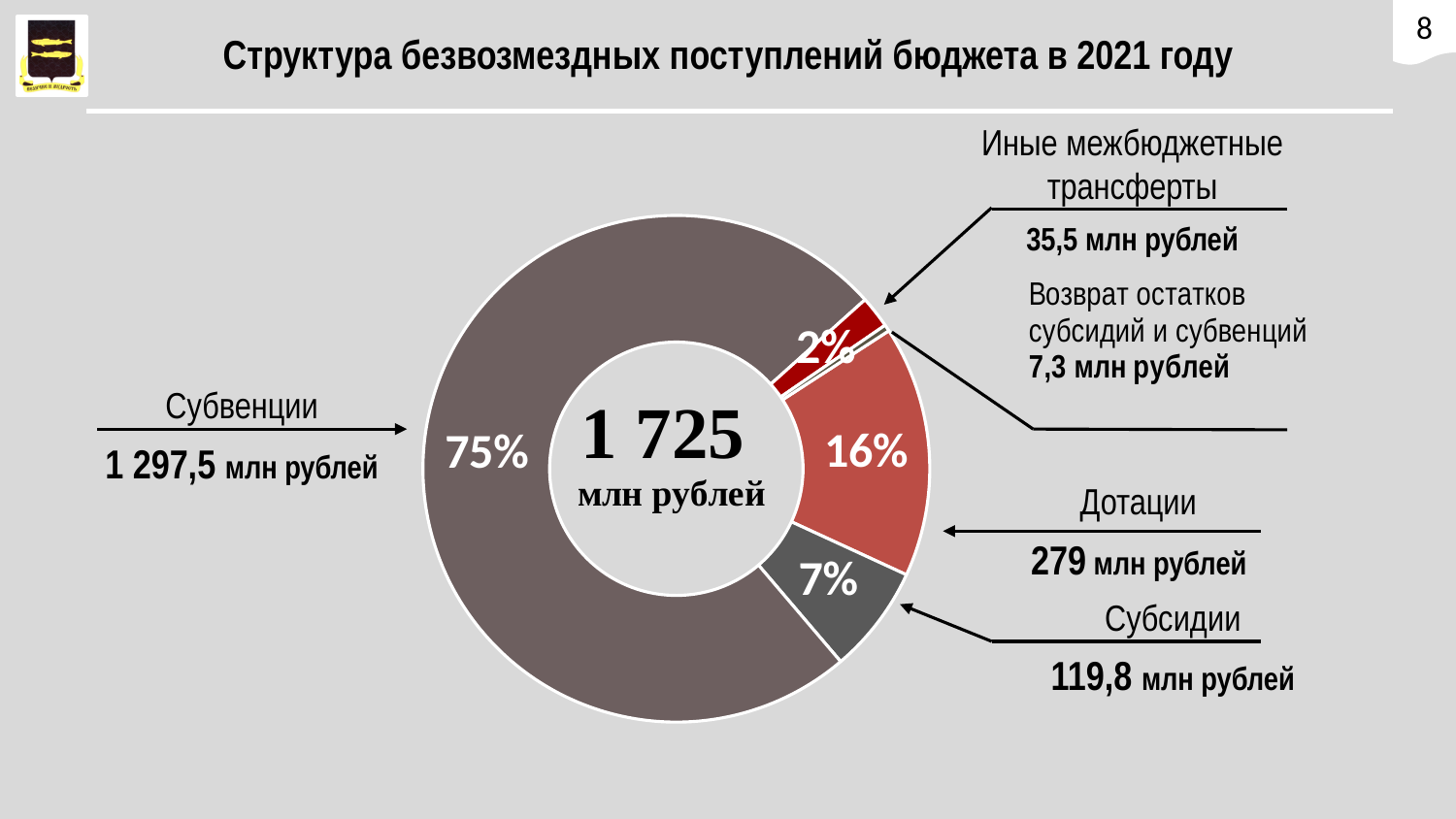
Which category has the largest share of the chart? Субвенции What kind of chart is shown on the slide? Pie (donut) chart What is the value shown for Субсидии? 119,8 млн рублей What is the value shown for Иные межбюджетные трансферты? 35,5 млн рублей What is the value shown for Возврат остатков субсидий и субвенций? 7,3 млн рублей What is the value shown for Дотации? 279 млн рублей What is the total shown in the centre of the chart? 1 725 млн рублей What is the value shown for Субвенции? 1 297,5 млн рублей What share of the chart does Дотации account for? 16% What share of the chart does Субвенции account for? 75% Which category has the smallest value on the chart? Возврат остатков субсидий и субвенций How many categories are shown on the chart? 5